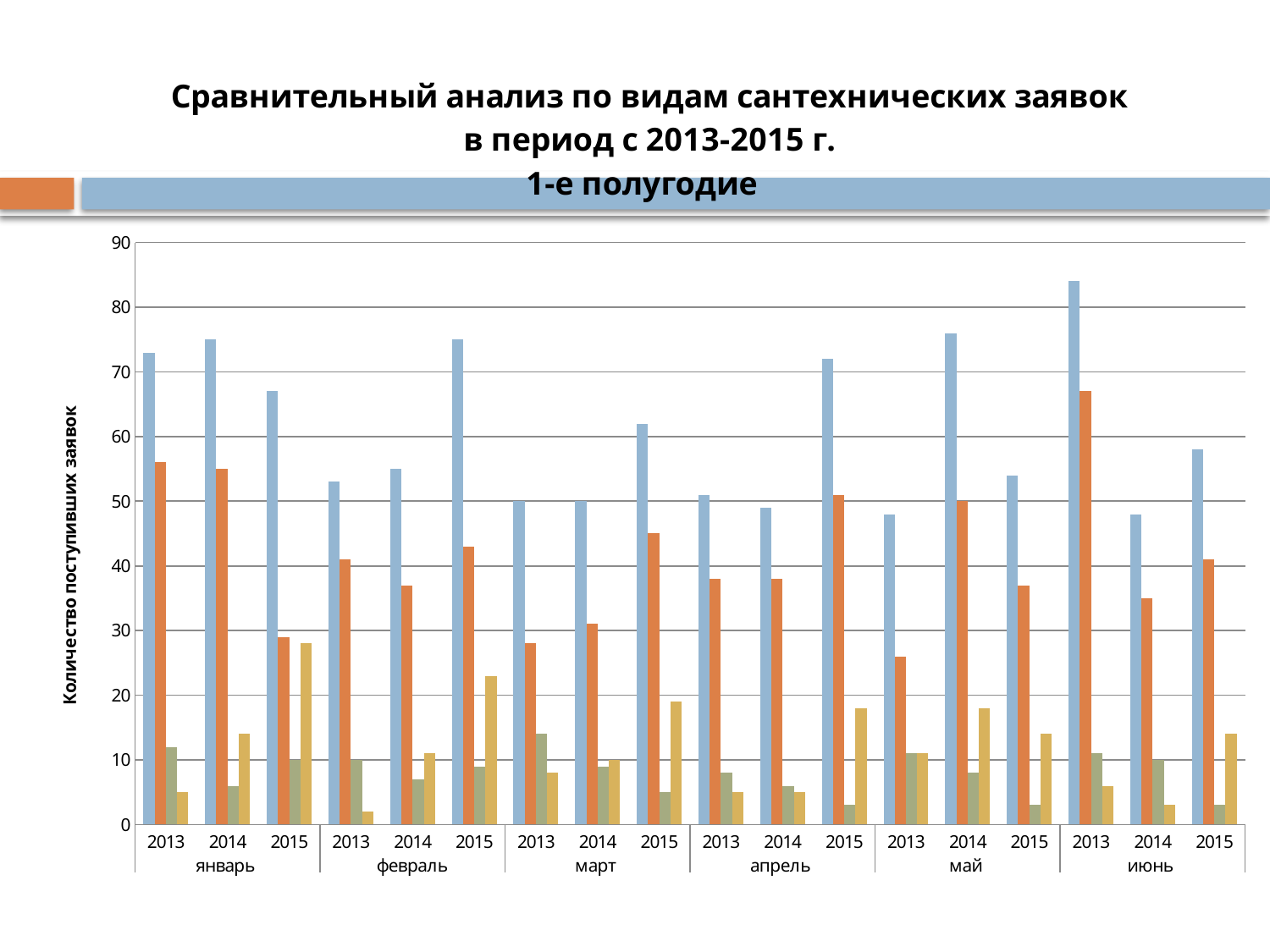
How many months are shown along the x axis? 6 What is the title of the vertical axis? Количество поступивших заявок What kind of chart is shown on the slide? bar chart How many bars are plotted in each year group (e.g. январь 2013)? 4 Is the yellow bar for февраль 2013 greater or less than 10? less Is the orange bar for июнь 2013 greater or less than 60? greater Do the orange bars for январь rise or fall from 2013 to 2015? fall In which month and year is the blue bar the tallest? июнь 2013 Is the orange bar for январь 2015 greater or less than 40? less In which month and year is the orange bar the tallest? июнь 2013 Which is taller: the blue bar for январь 2013 or the blue bar for февраль 2013? январь 2013